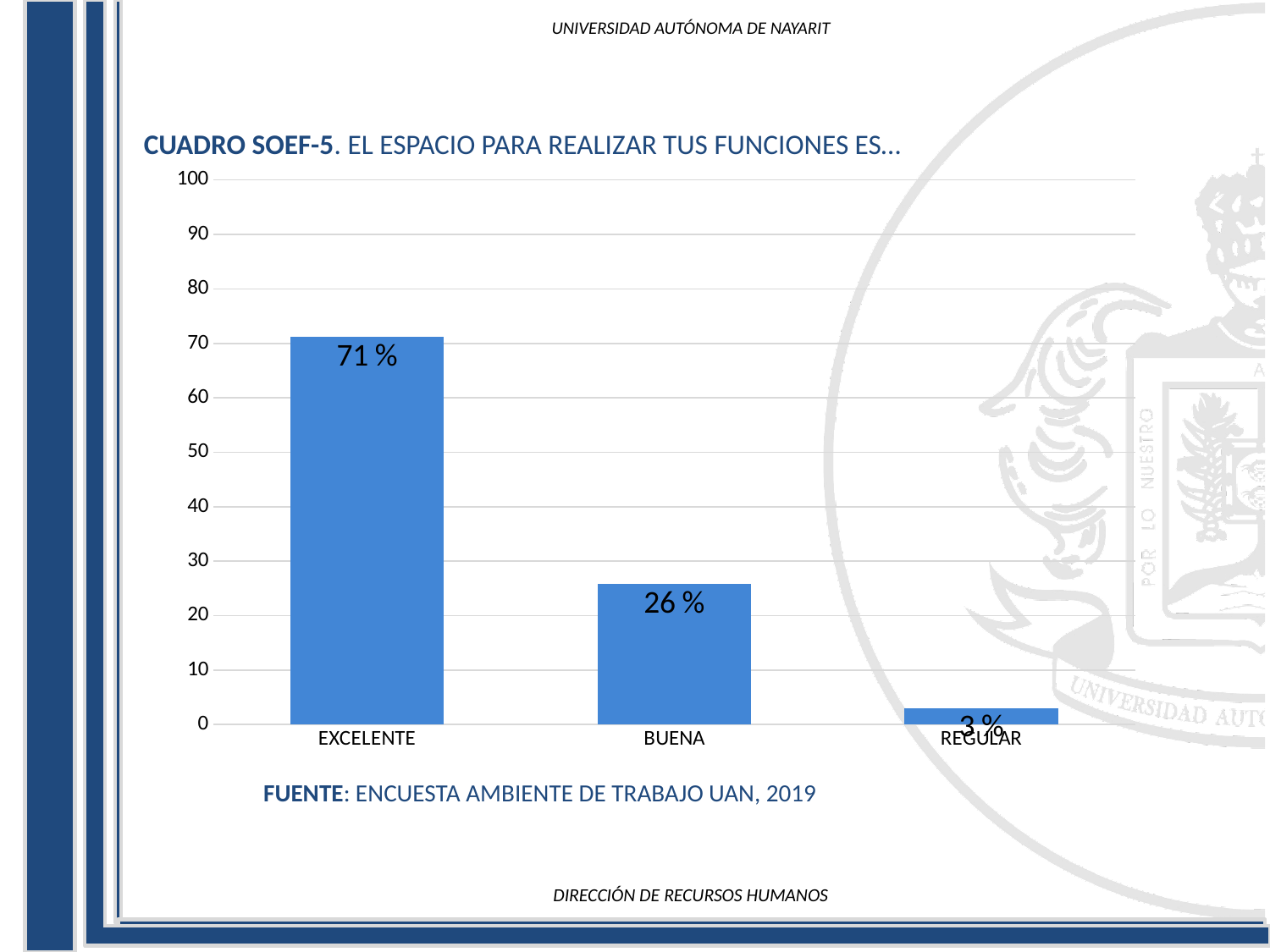
What is the value for BUENA? 26 % What is the value for REGULAR? 3 % What is the difference between the values for BUENA and REGULAR? 23 % Which category has the highest value? EXCELENTE What kind of chart is shown on the slide? bar chart Which is larger, the value for BUENA or the value for REGULAR? BUENA How many categories are shown on the x axis? 3 Do the values rise or fall from left to right along the x axis? fall What is the value for EXCELENTE? 71 % What is the difference between the values for EXCELENTE and BUENA? 45 % Is the value for EXCELENTE greater or less than 60? greater Which category has the lowest value? REGULAR